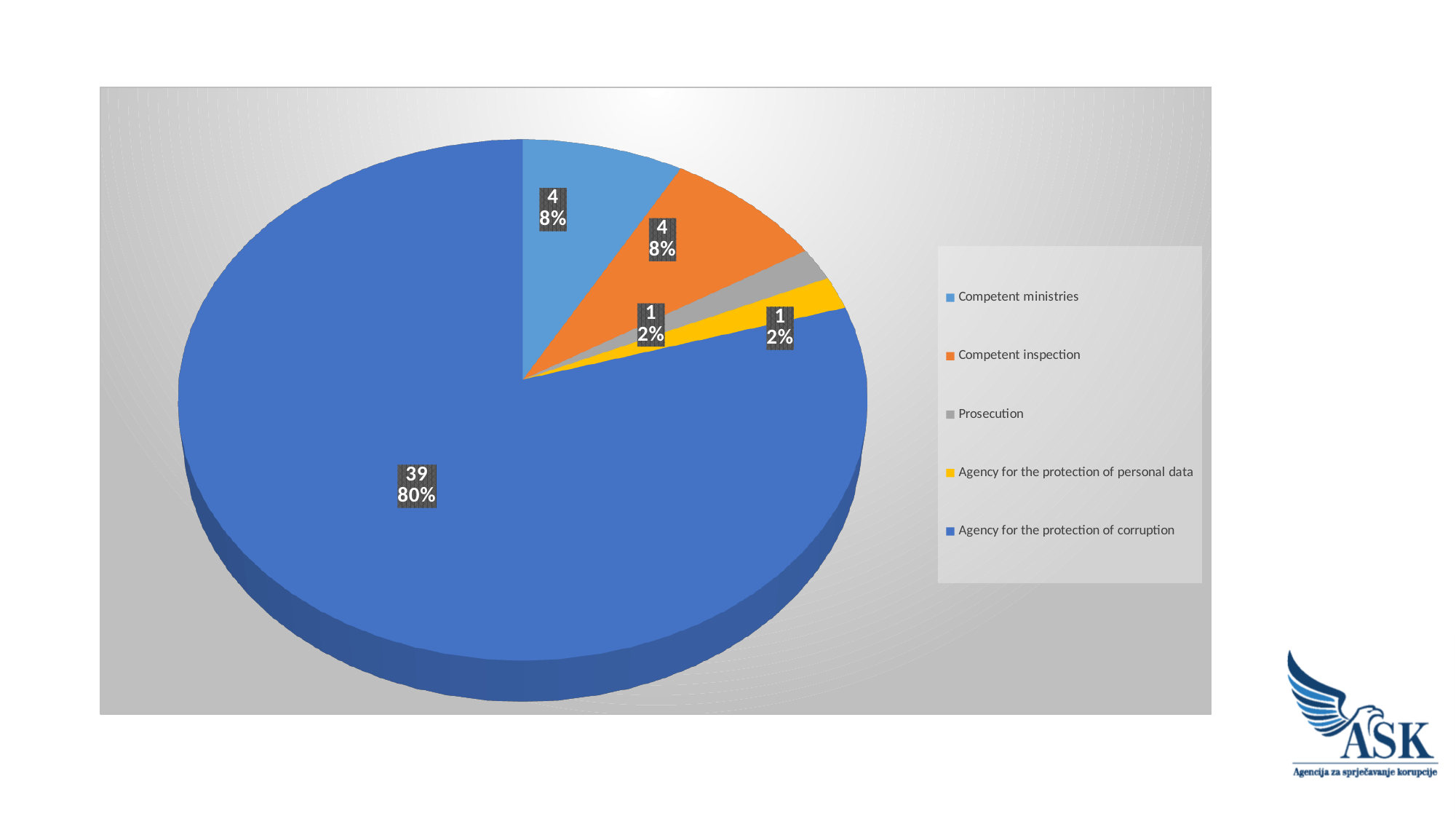
What is the value for Agency for the protection of corruption? 39 What is the difference between the value for Agency for the protection of corruption and the value for Competent inspection? 35 Which category has the largest slice of the pie? Agency for the protection of corruption What is the value for Competent ministries? 4 What share of the pie does Agency for the protection of personal data represent? 2% What kind of chart is shown on the slide? Pie chart Which is larger, the value for Competent ministries or the value for Prosecution? Competent ministries What is the value for Prosecution? 1 What share of the pie does Competent inspection represent? 8% What share of the pie does Agency for the protection of corruption represent? 80% Which colour represents Agency for the protection of personal data in the legend? Yellow How many categories does the pie chart have? 5